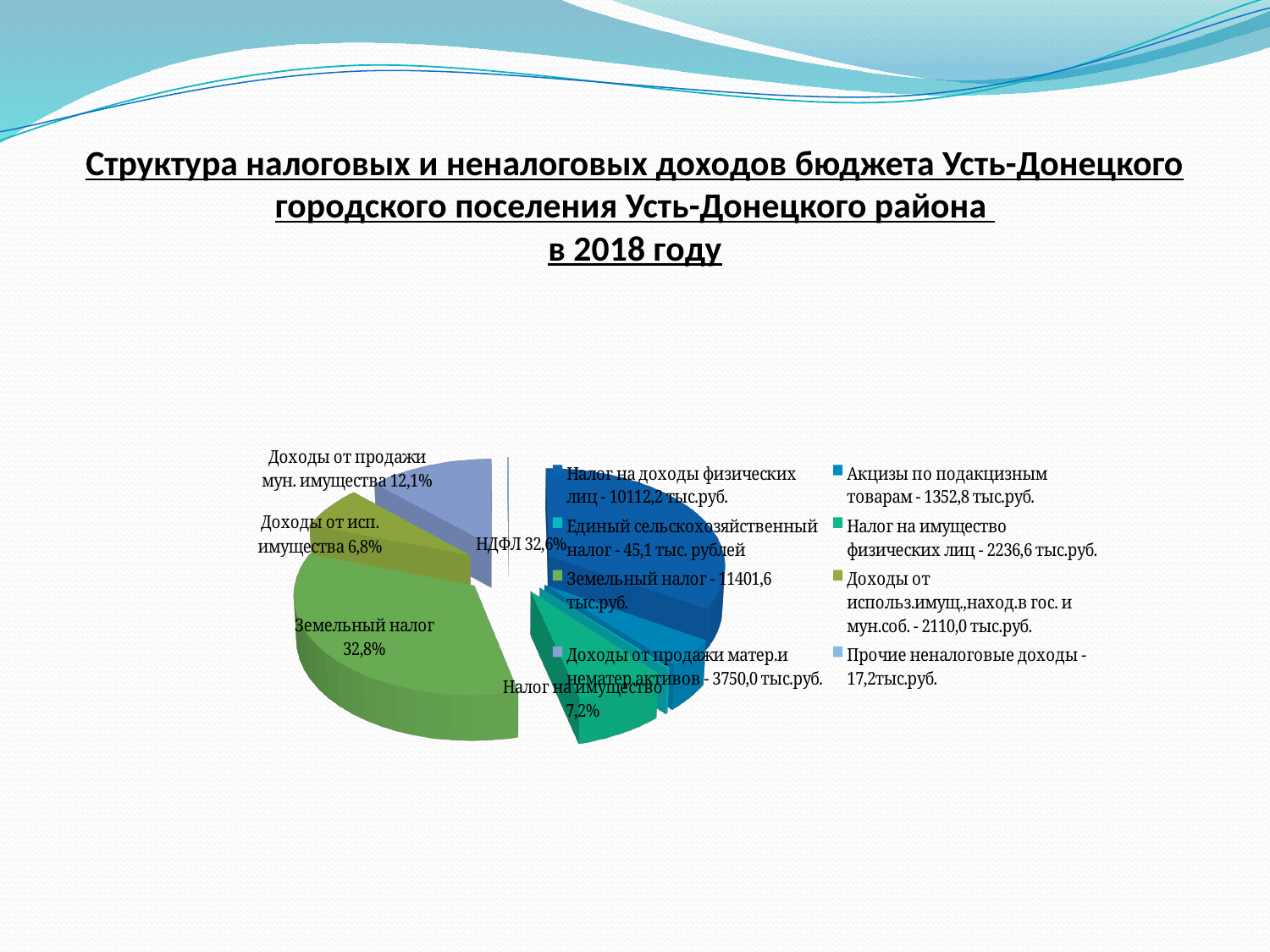
Which is larger: the share for Доходы от продажи мун. имущества or the share for Налог на имущество? Доходы от продажи мун. имущества What share of the pie is labelled for Земельный налог? 32,8% What share of the pie is labelled for НДФЛ? 32,6% Which labelled slice has the smallest share of the pie? Доходы от исп. имущества What is the difference in percentage points between the share for Доходы от продажи мун. имущества and the share for Доходы от исп. имущества? 5,3 What kind of chart is shown on the slide? pie chart What share of the pie is labelled for Доходы от продажи мун. имущества? 12,1% According to the legend, what amount is given for Земельный налог? 11401,6 тыс.руб. What share of the pie is labelled for Налог на имущество? 7,2% Which labelled slice has the largest share of the pie? Земельный налог How many entries does the legend list? 8 What share of the pie is labelled for Доходы от исп. имущества? 6,8%